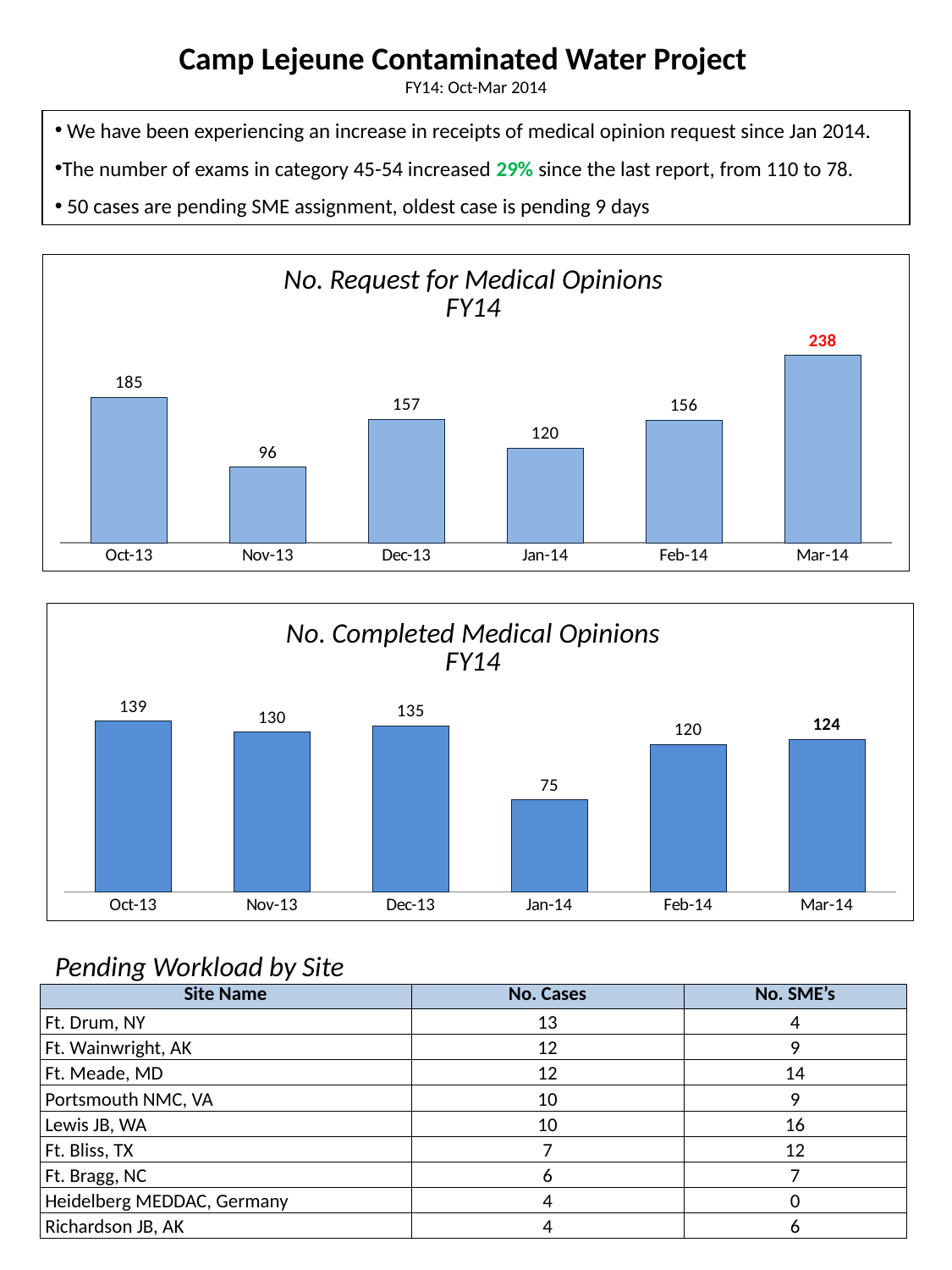
In the 'No. Request for Medical Opinions FY14' chart, which data label is shown in red? 238 (Mar-14) In the 'No. Request for Medical Opinions FY14' chart, do the values rise or fall from Jan-14 to Mar-14? rise What type of chart is the 'No. Completed Medical Opinions FY14' chart? bar chart In the 'No. Completed Medical Opinions FY14' chart, which is larger, the value for Feb-14 or Mar-14? Mar-14 In the 'No. Completed Medical Opinions FY14' chart, what is the value for Jan-14? 75 In the 'No. Request for Medical Opinions FY14' chart, what is the value for Mar-14? 238 In the 'No. Completed Medical Opinions FY14' chart, what is the difference between the Dec-13 and Jan-14 values? 60 In the 'No. Request for Medical Opinions FY14' chart, which is larger, the value for Oct-13 or Dec-13? Oct-13 In the 'No. Request for Medical Opinions FY14' chart, how many months are plotted? 6 In the 'No. Request for Medical Opinions FY14' chart, what is the difference between the Mar-14 and Feb-14 values? 82 In the 'No. Request for Medical Opinions FY14' chart, which month has the lowest value? Nov-13 In the 'No. Completed Medical Opinions FY14' chart, which month has the highest value? Oct-13